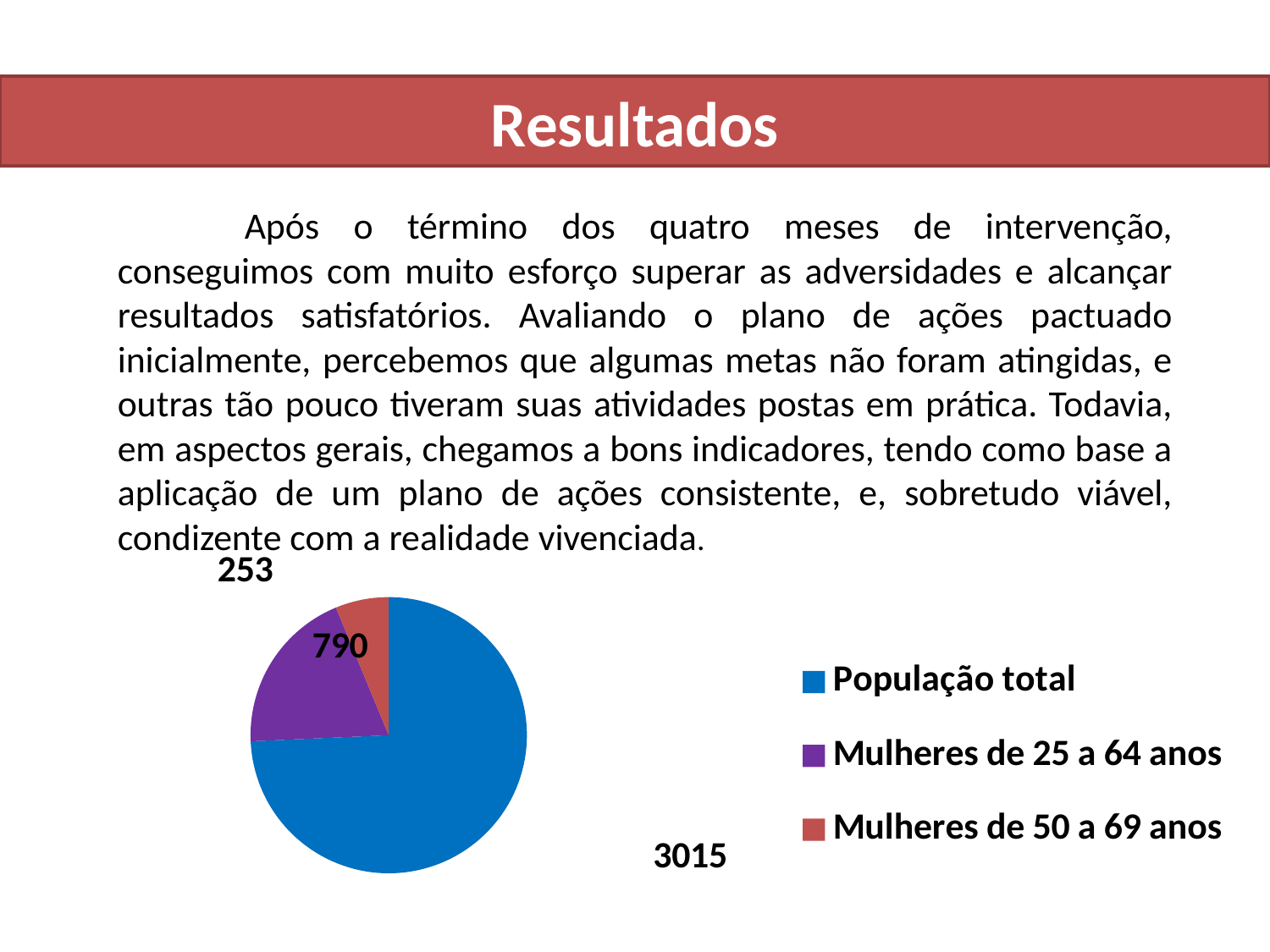
Which category has the smallest slice in the pie chart? Mulheres de 50 a 69 anos What colour is the slice for Mulheres de 25 a 64 anos in the pie chart? Purple What is the value for Mulheres de 50 a 69 anos in the pie chart? 253 What is the value for População total in the pie chart? 3015 What is the value for Mulheres de 25 a 64 anos in the pie chart? 790 What is the difference between the values for População total and Mulheres de 25 a 64 anos? 2225 How many slices does the pie chart have? 3 What type of chart is shown on the slide? Pie chart How many entries does the legend of the pie chart list? 3 What is the difference between the values for Mulheres de 25 a 64 anos and Mulheres de 50 a 69 anos? 537 Which is larger, the value for Mulheres de 25 a 64 anos or the value for Mulheres de 50 a 69 anos? Mulheres de 25 a 64 anos Which category has the largest slice in the pie chart? População total